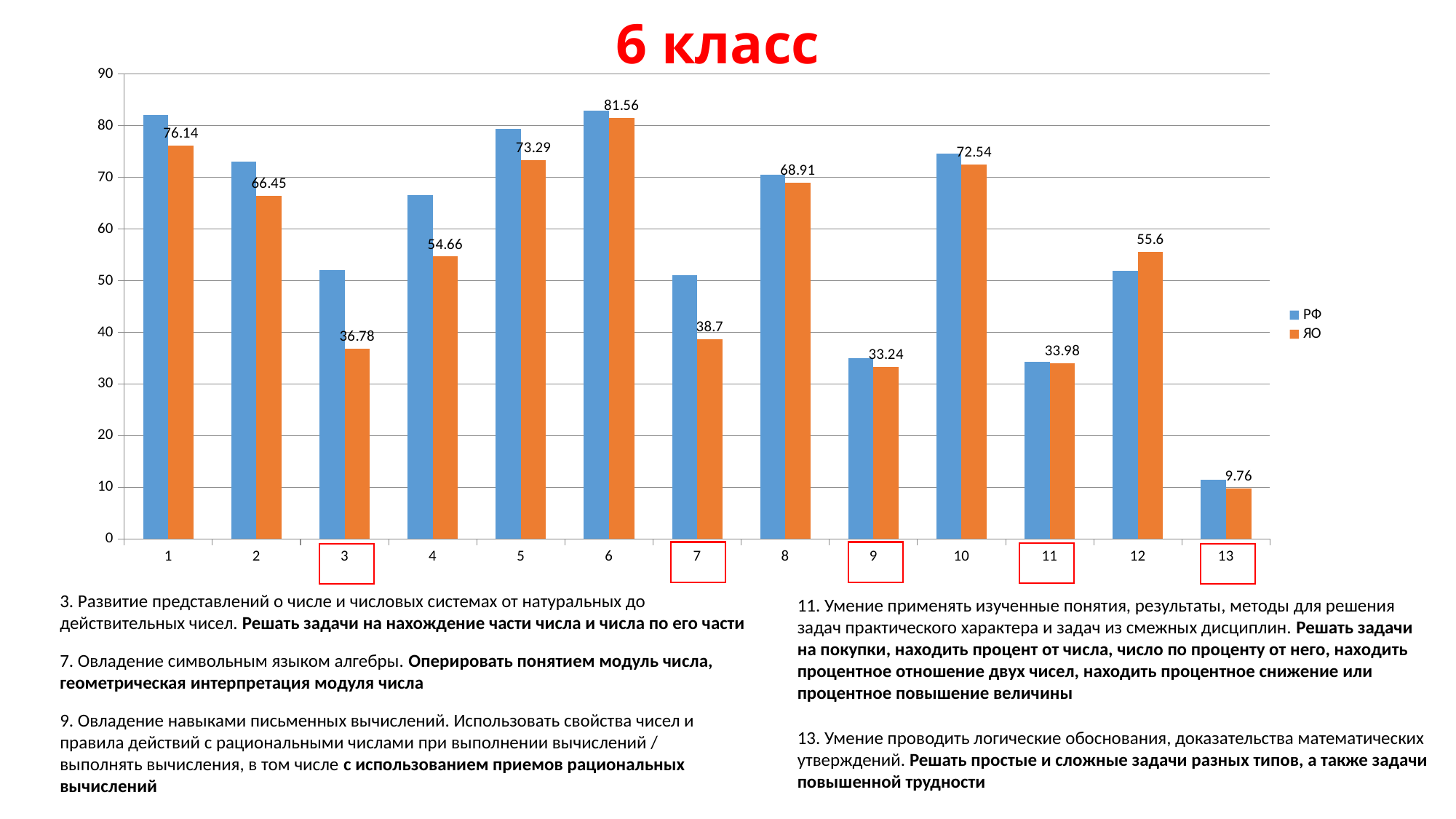
What is the value for ЯО in category 13? 9.76 Is the РФ value for category 1 greater or less than 80? greater How many categories are shown on the x axis? 13 What is the title of the slide above the chart? 6 класс In category 12, which series has the larger value, РФ or ЯО? ЯО Which category has the highest ЯО value? 6 Which category has the lowest ЯО value? 13 What is the difference between the ЯО values for category 1 and category 2? 9.69 What is the value for ЯО in category 3? 36.78 How many series does the legend list? 2 What is the value for ЯО in category 6? 81.56 In category 3, which series has the larger value, РФ or ЯО? РФ